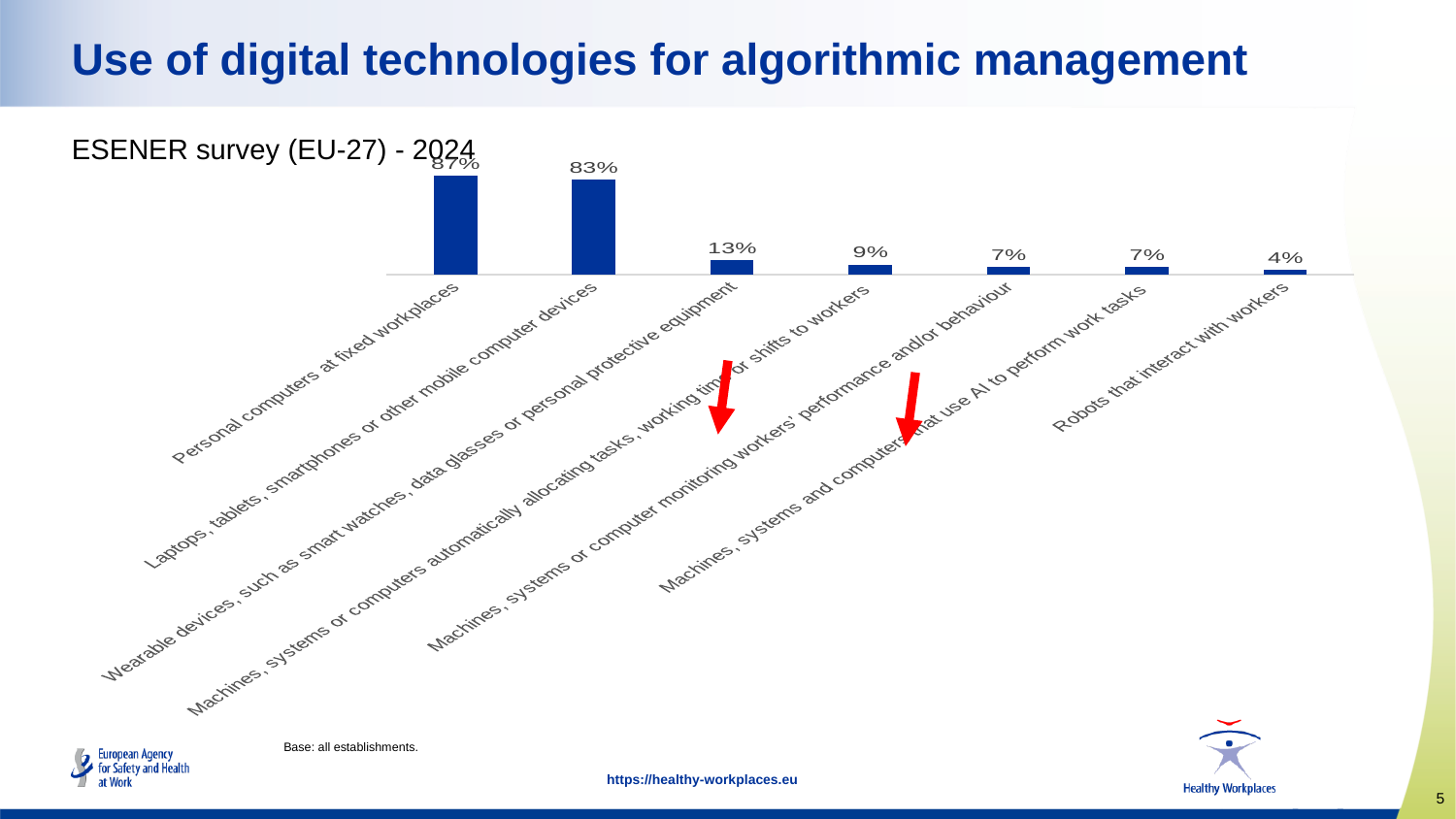
What percentage is shown for machines, systems or computers automatically allocating tasks, working time or shifts to workers? 9% What is the value for robots that interact with workers? 4% What percentage of establishments use personal computers at fixed workplaces? 87% What type of chart is shown on the slide? Bar chart What percentage is shown for wearable devices, such as smart watches, data glasses or personal protective equipment? 13% What is the value for laptops, tablets, smartphones or other mobile computer devices? 83% Which survey and year does the chart subtitle refer to? ESENER survey (EU-27) - 2024 Which category has the highest value? Personal computers at fixed workplaces What is the difference between the values for personal computers at fixed workplaces and laptops, tablets, smartphones or other mobile computer devices? 4 percentage points Which category has the lowest value? Robots that interact with workers Which is larger: the value for wearable devices or the value for machines, systems or computer monitoring workers' performance and/or behaviour? Wearable devices How many categories are shown in the chart? 7